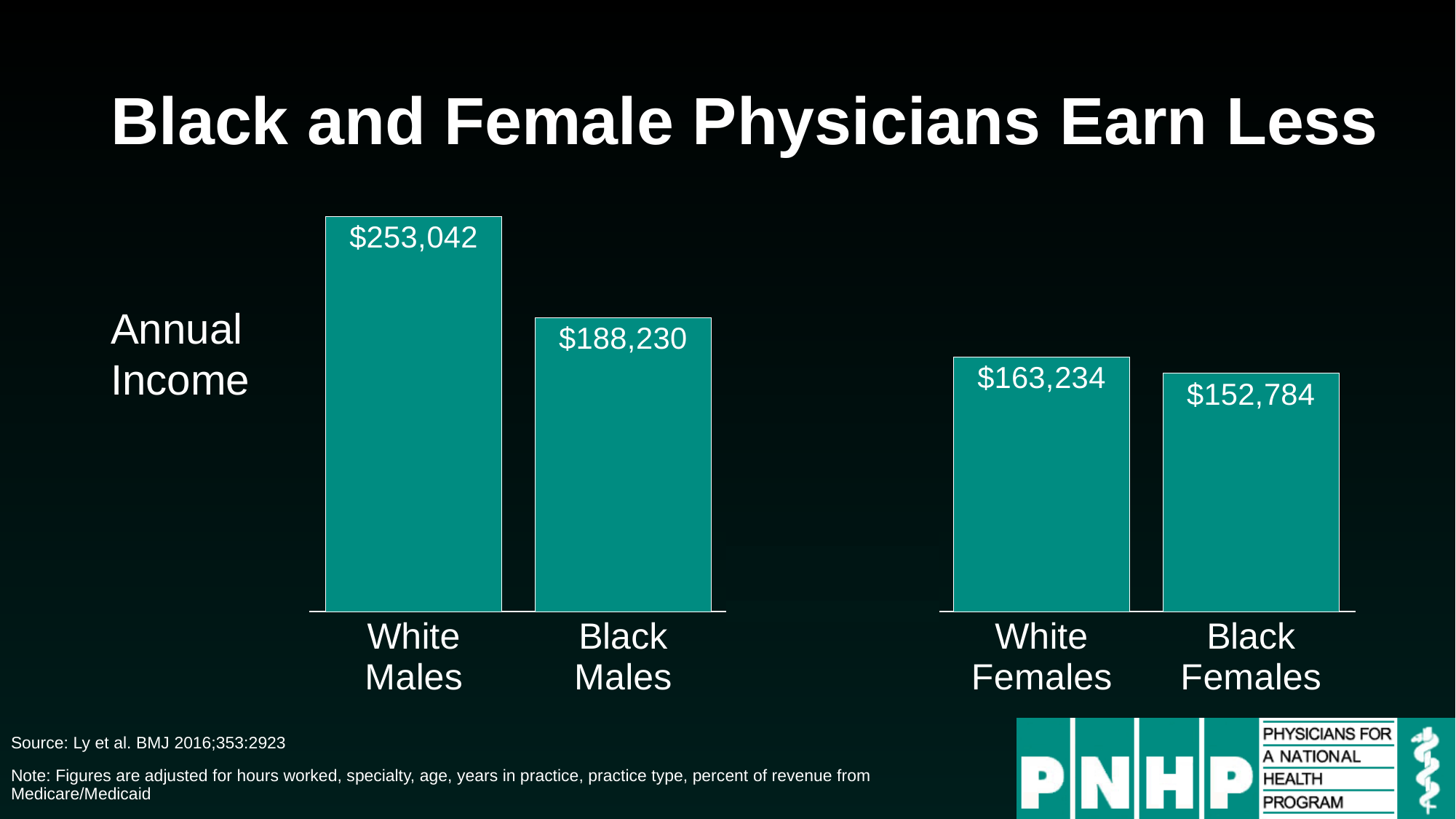
Which group has the lowest annual income on the slide? Black Females How many groups (bars) are shown on the slide? 4 What is the difference in annual income between White Males and Black Males? $64,812 What is the annual income shown for Black Males? $188,230 What is the annual income shown for White Males? $253,042 What is the title of the slide? Black and Female Physicians Earn Less What is the annual income shown for Black Females? $152,784 Which group has the highest annual income on the slide? White Males What is the difference in annual income between White Females and Black Females? $10,450 What is the annual income shown for White Females? $163,234 Which group earns more, Black Males or White Females? Black Males What kind of chart is shown on the slide? Bar chart